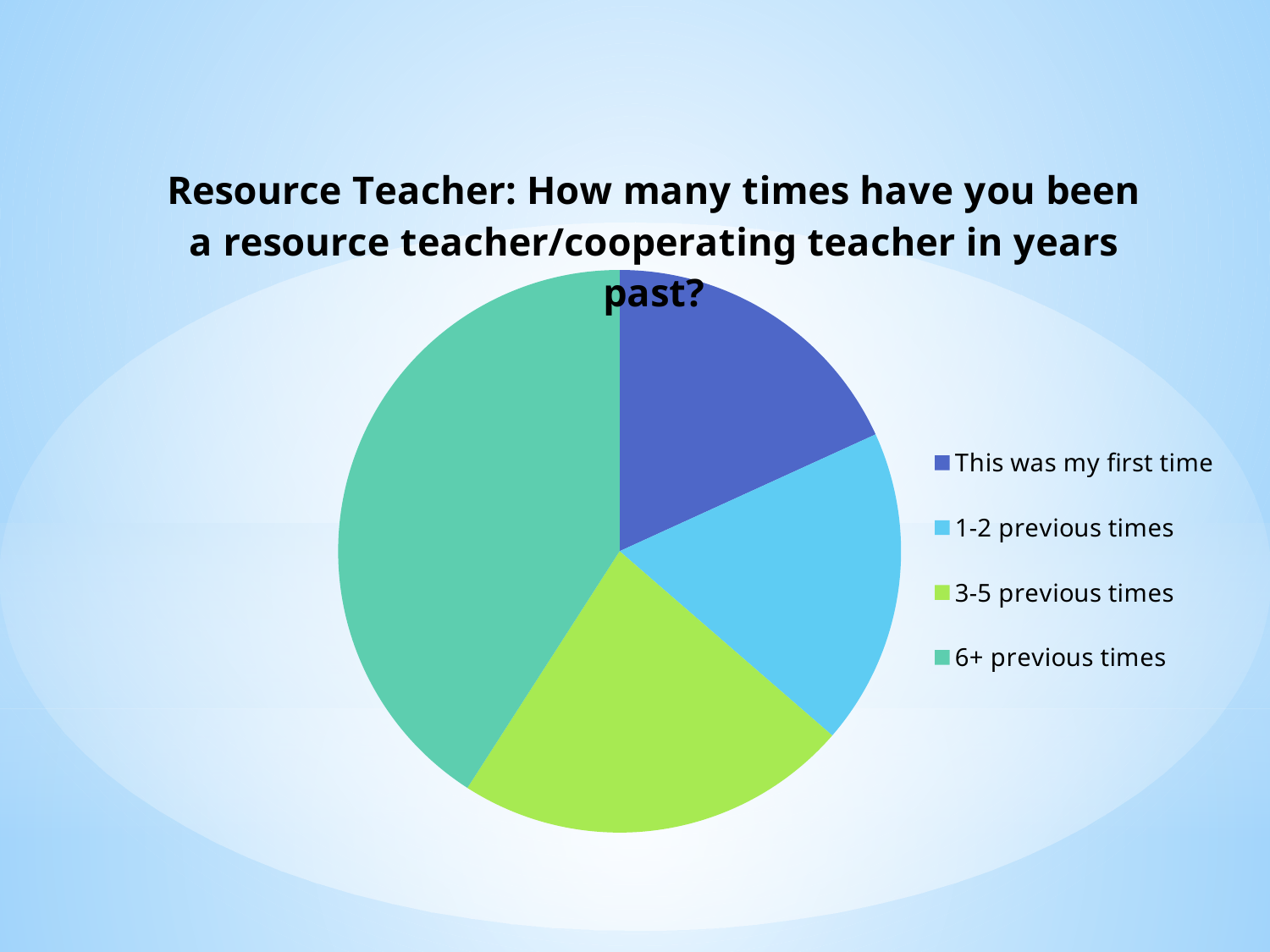
Which category has the largest slice of the pie chart? 6+ previous times Which slice is larger: "3-5 previous times" or "1-2 previous times"? 3-5 previous times How many slices does the pie chart have? 4 Which category is shown in green in the pie chart? 3-5 previous times Which slice is larger: "6+ previous times" or "3-5 previous times"? 6+ previous times Which slice is larger: "6+ previous times" or "This was my first time"? 6+ previous times What kind of chart is shown on the slide? Pie chart How many entries does the legend list? 4 What is the title of the pie chart? Resource Teacher: How many times have you been a resource teacher/cooperating teacher in years past?